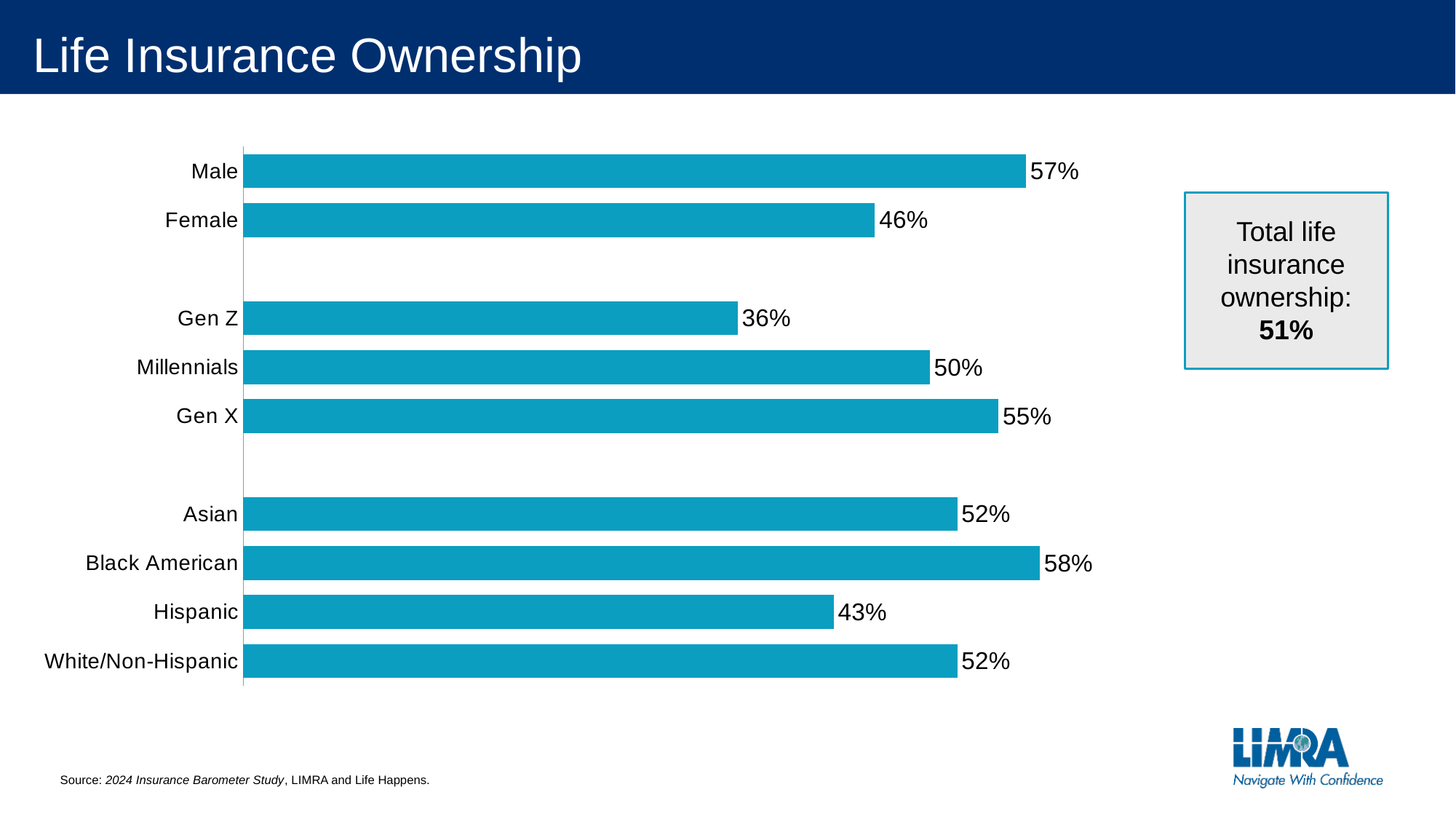
What is the difference between the Male and Female values? 11% What is the difference between the Gen X and Gen Z values? 19% What kind of chart is shown on the slide? Bar chart How many categories are plotted in the chart? 9 Which is larger, the value for Asian or the value for Hispanic? Asian Which category has the highest life insurance ownership? Black American What is the life insurance ownership value for Millennials? 50% What is the life insurance ownership value for Male? 57% What total life insurance ownership figure is shown in the box beside the chart? 51% Which category has the lowest life insurance ownership? Gen Z What is the life insurance ownership value for Hispanic? 43% What is the life insurance ownership value for Gen Z? 36%